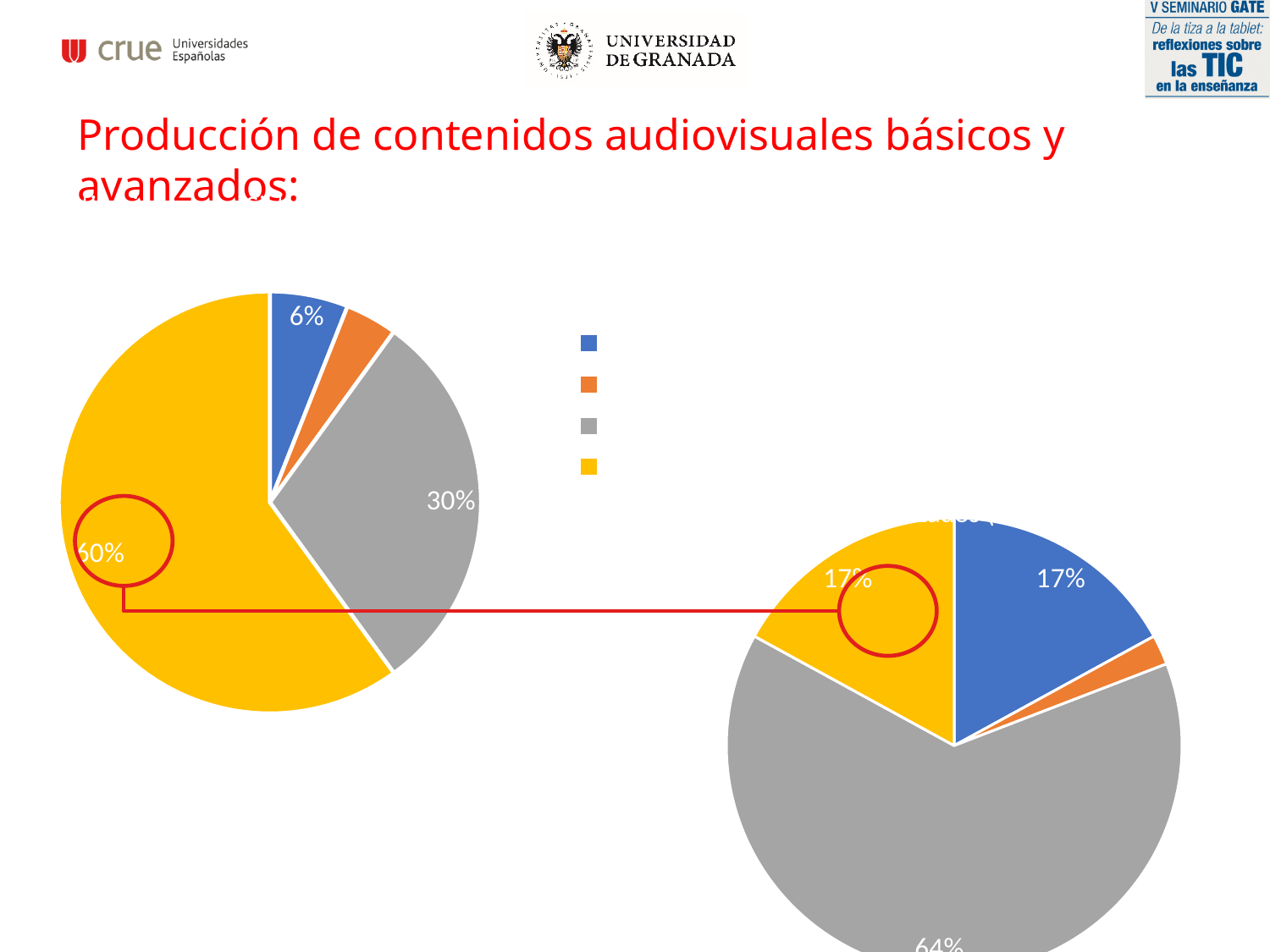
In the right pie chart, what percentage is shown for the blue slice? 17% In the right pie chart, what percentage is shown for the grey slice? 64% In the left pie chart, what is the difference between the yellow slice and the grey slice? 30% In the left pie chart, which colour slice is the largest? Yellow How many entries does the legend show? 4 In the left pie chart, what percentage is shown for the grey slice? 30% In the left pie chart, which colour slice is the smallest? Orange In the left pie chart, what percentage is shown for the yellow slice? 60% In the left pie chart, what percentage is shown for the blue slice? 6% What kind of charts are shown on the slide? Pie charts How many pie charts are on the slide? 2 In the right pie chart, which colour slice is the largest? Grey